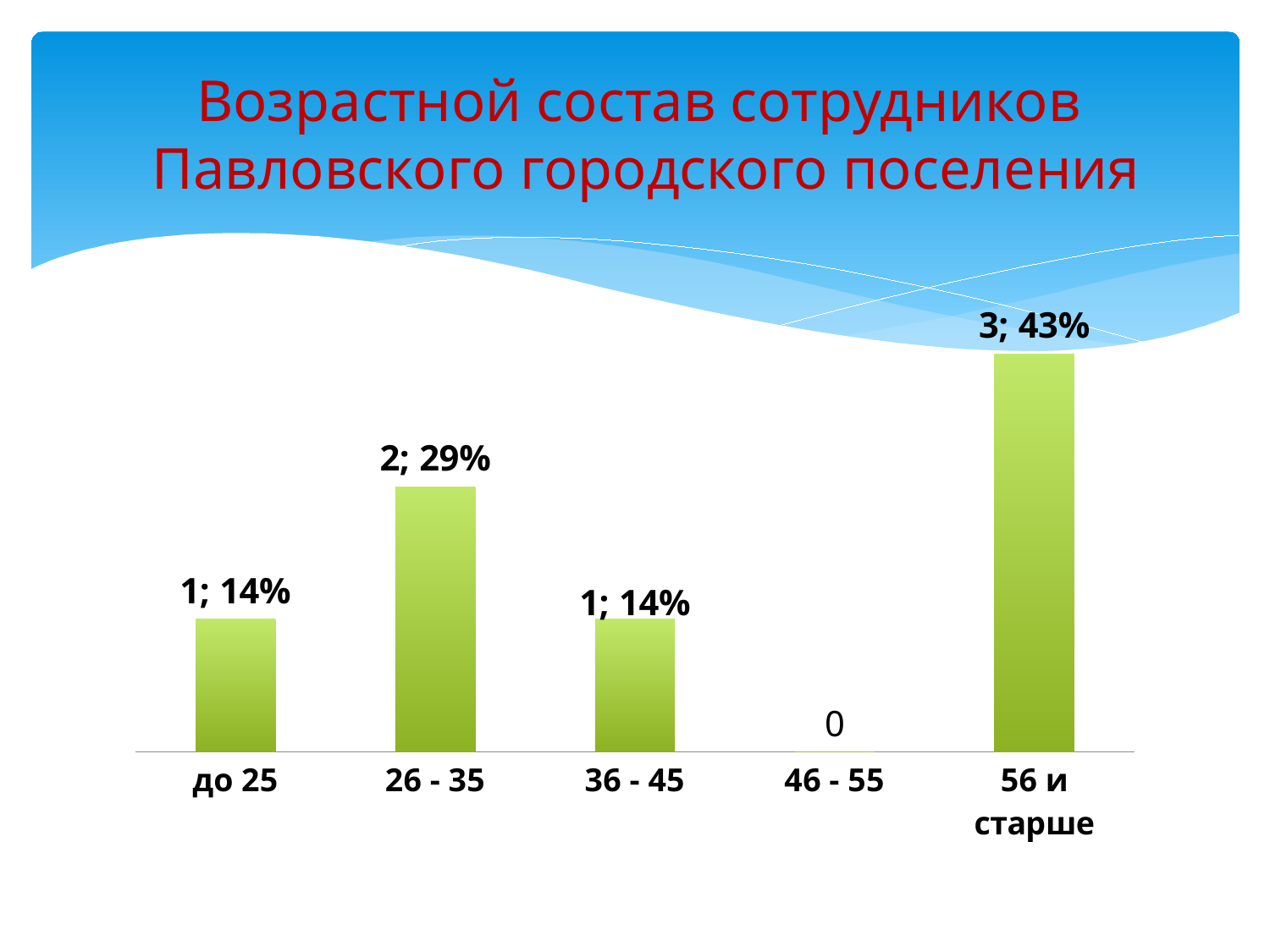
What is the total count across all categories? 7 What is the data label for the "56 и старше" category? 3; 43% What is the data label for the "до 25" category? 1; 14% How many categories are shown on the x axis? 5 What kind of chart is shown on the slide? bar chart Which category has the highest value? 56 и старше Which category has the lowest value? 46 - 55 What is the data label for the "26 - 35" category? 2; 29% What is the difference between the count for "56 и старше" and the count for "26 - 35"? 1 What is the value shown for the "46 - 55" category? 0 Which is larger, the value for "26 - 35" or the value for "36 - 45"? 26 - 35 What is the title of the slide? Возрастной состав сотрудников Павловского городского поселения